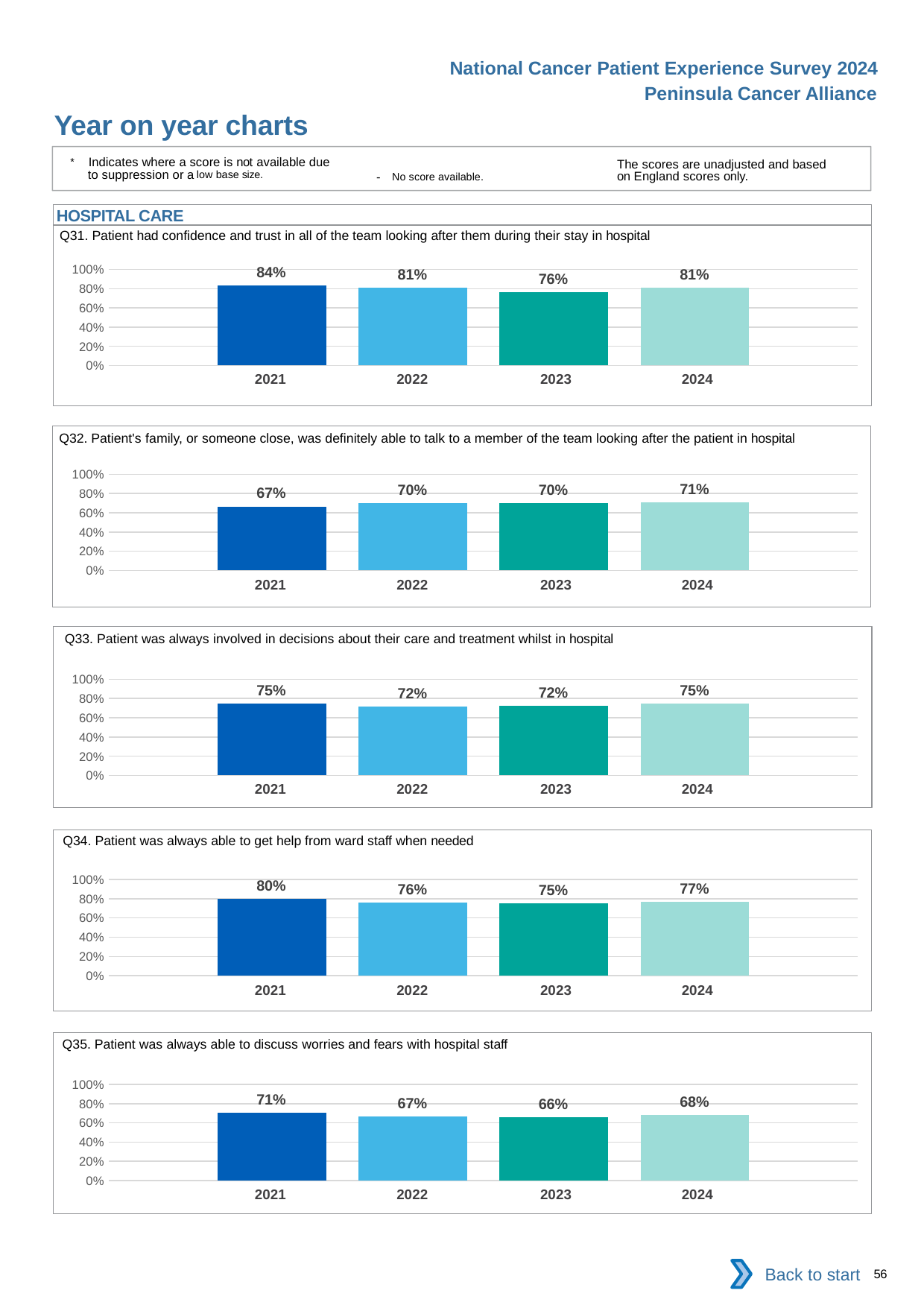
In the Q34 chart, which is larger, the value for 2021 or the value for 2024? 2021 In the Q32 chart, which year has the lowest value? 2021 In the Q31 chart, which year has the highest value? 2021 In the Q31 chart, what is the value for 2023? 76% What kind of chart is the Q31 chart? Bar chart How many years are shown on the x axis of the Q33 chart? 4 In the Q32 chart, what is the difference between the 2024 value and the 2021 value? 4 percentage points In the Q32 chart, what is the value for 2021? 67% In the Q35 chart, what is the value for 2024? 68% In the Q35 chart, which year has the lowest value? 2023 In the Q34 chart, what is the difference between the 2021 value and the 2023 value? 5 percentage points In the Q33 chart, what is the value for 2022? 72%